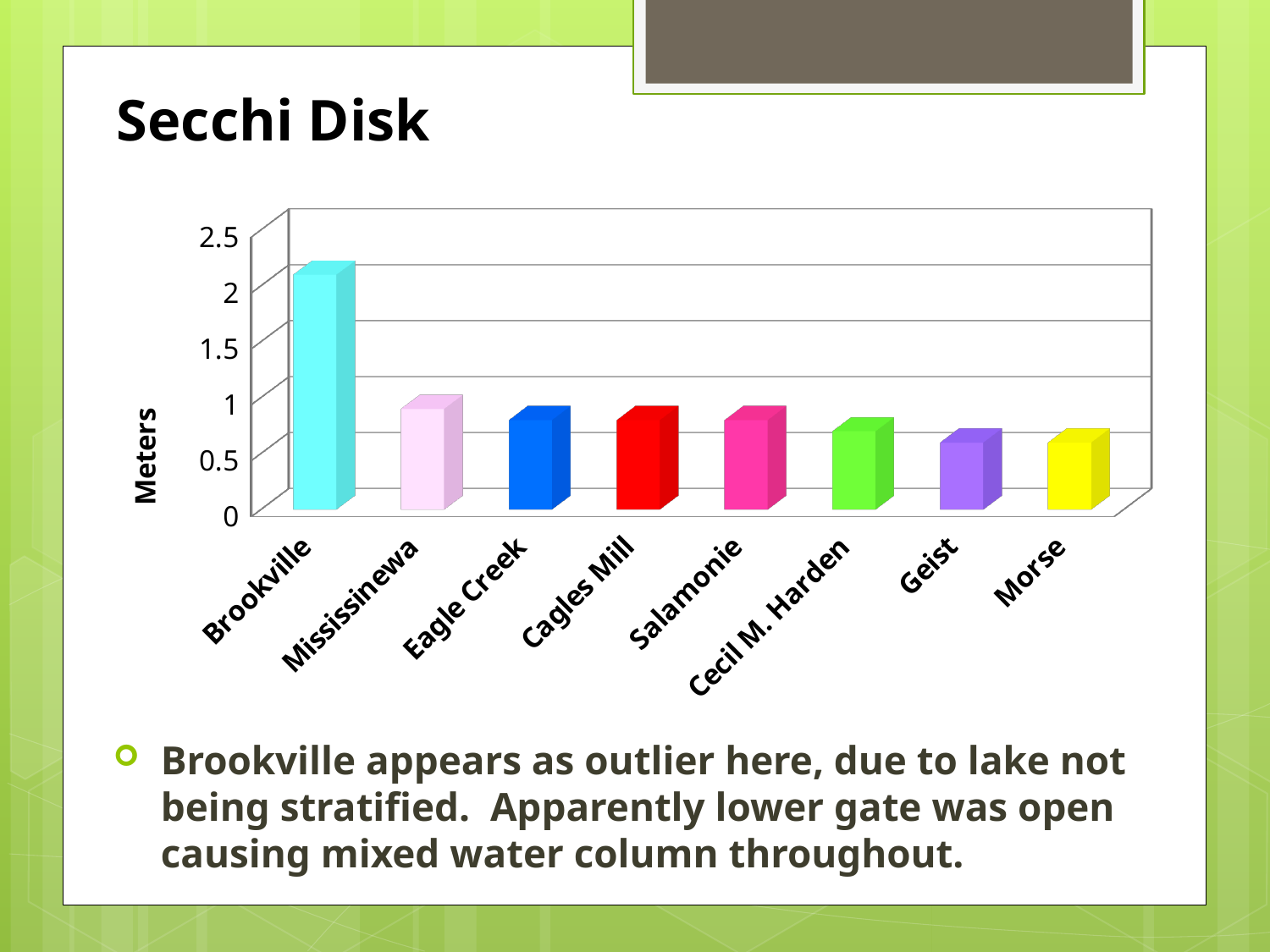
Do the values generally rise or fall moving from left to right along the x axis? Fall Which lake has the highest Secchi disk value? Brookville What is the title of the slide containing the chart? Secchi Disk What kind of chart is shown on the slide? Bar chart What is the label on the vertical axis of the chart? Meters Is the value for Geist greater or less than 1? less How many lakes (categories) are plotted on the chart? 8 Is the value for Eagle Creek greater or less than 1? less Is the value for Brookville greater or less than 1.5? greater Which is larger, the value for Mississinewa or the value for Morse? Mississinewa Which is larger, the value for Brookville or the value for Mississinewa? Brookville